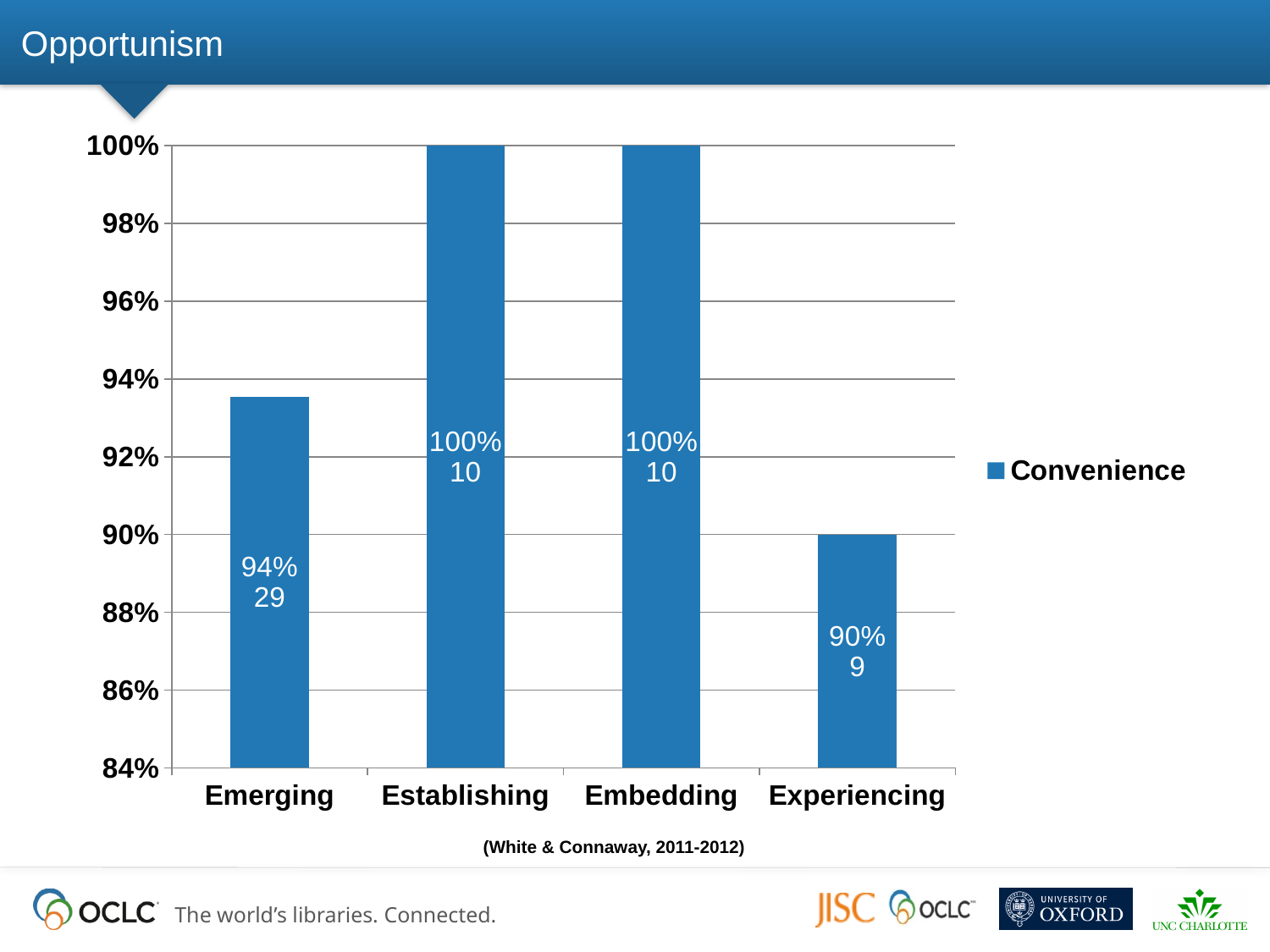
What percentage is shown for the Emerging category? 94% Which category has the lowest percentage? Experiencing Is the value for Experiencing greater or less than 92%? less What kind of chart is shown on the slide? Bar chart What percentage is shown for the Experiencing category? 90% What count is printed on the Emerging bar below its percentage? 29 What count is printed on the Experiencing bar below its percentage? 9 How many series does the legend list? 1 What is the name of the series in the legend? Convenience How many categories are shown on the x axis? 4 What is the difference in percentage points between Establishing and Experiencing? 10 percentage points Which has a higher percentage, Emerging or Experiencing? Emerging